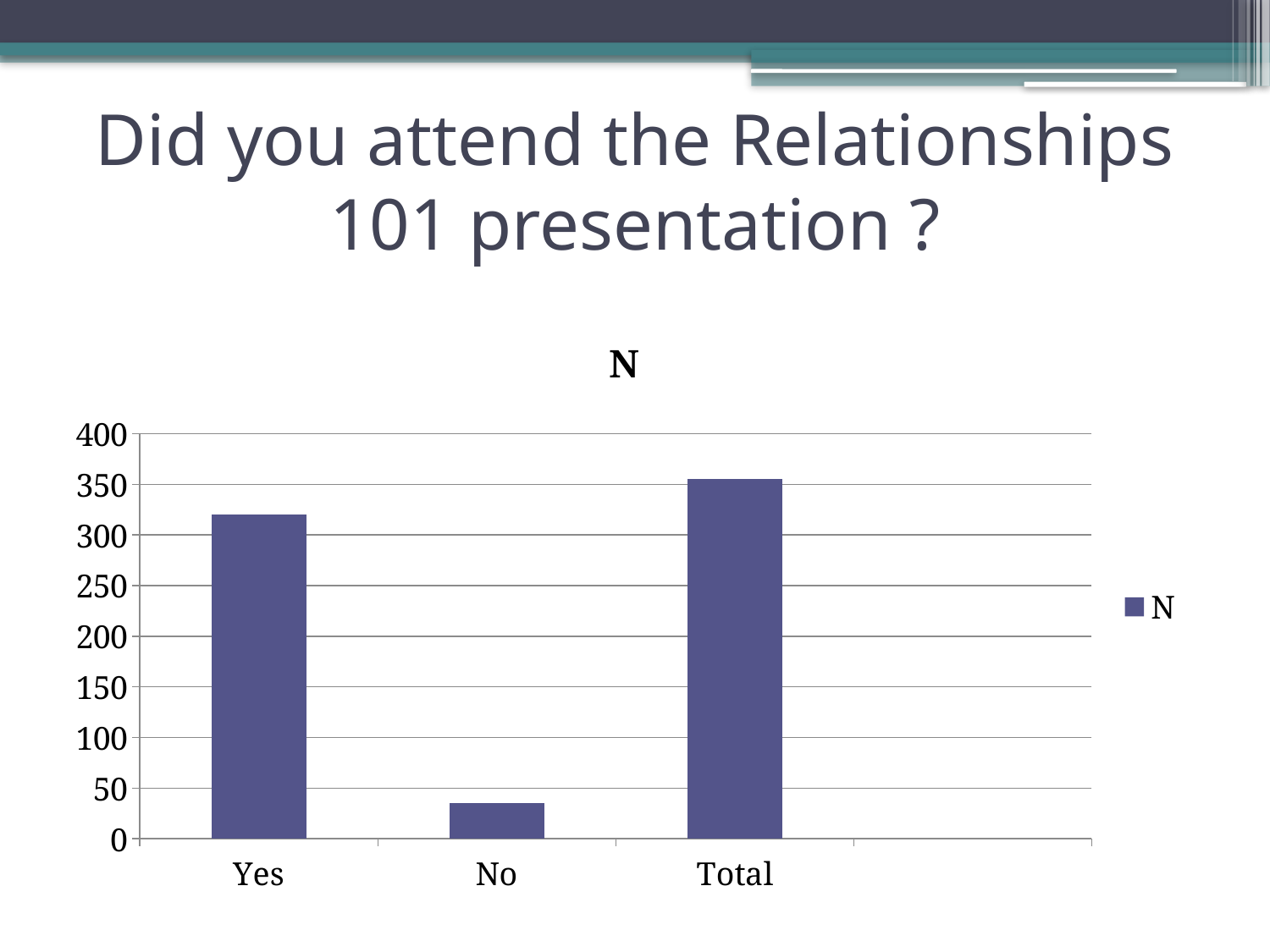
Which category has the highest value? Total Is the value for Yes greater or less than 300? greater What is the title of the chart? N Is the value for Yes greater or less than 350? less Is the value for No greater or less than 50? less What kind of chart is shown on the slide? bar chart How many series does the legend list? 1 Which category has the lowest value? No How many categories are shown on the x axis of the chart? 3 Which is larger, the value for Yes or the value for No? Yes What is the name of the series shown in the legend? N